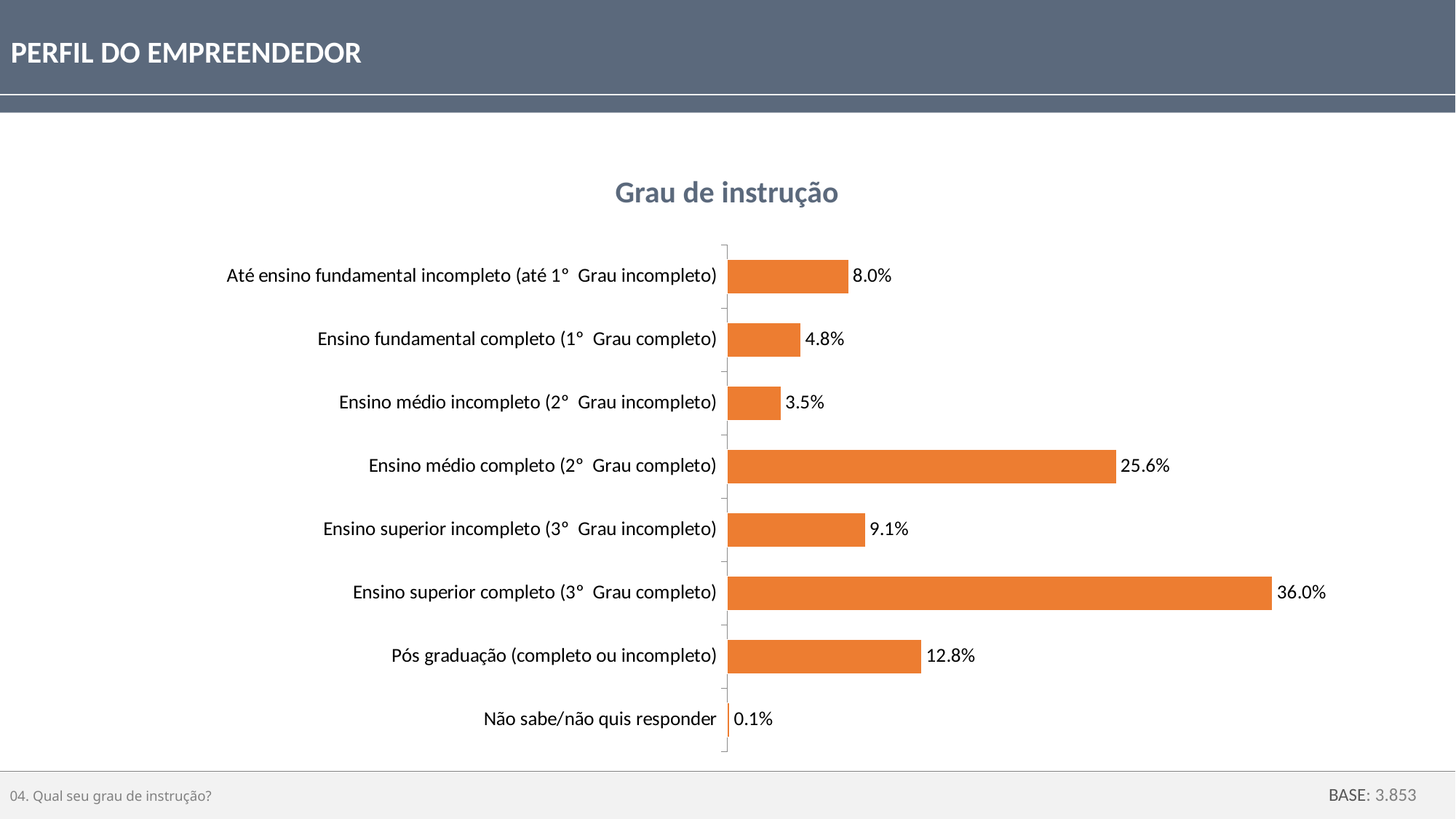
Which category has the highest value? Ensino superior completo (3° Grau completo) How many categories are shown in the chart? 8 What is the title of the chart? Grau de instrução What is the value for Ensino médio incompleto (2° Grau incompleto)? 3.5% What is the difference between Ensino superior completo (3° Grau completo) and Ensino médio completo (2° Grau completo)? 10.4% What kind of chart is shown on the slide? Bar chart Which is larger, Pós graduação (completo ou incompleto) or Ensino superior incompleto (3° Grau incompleto)? Pós graduação (completo ou incompleto) What is the value for Pós graduação (completo ou incompleto)? 12.8% Which category has the lowest value? Não sabe/não quis responder What is the value for Ensino superior completo (3° Grau completo)? 36.0% What is the value for Ensino médio completo (2° Grau completo)? 25.6% What is the difference between Ensino superior incompleto (3° Grau incompleto) and Até ensino fundamental incompleto (até 1° Grau incompleto)? 1.1%